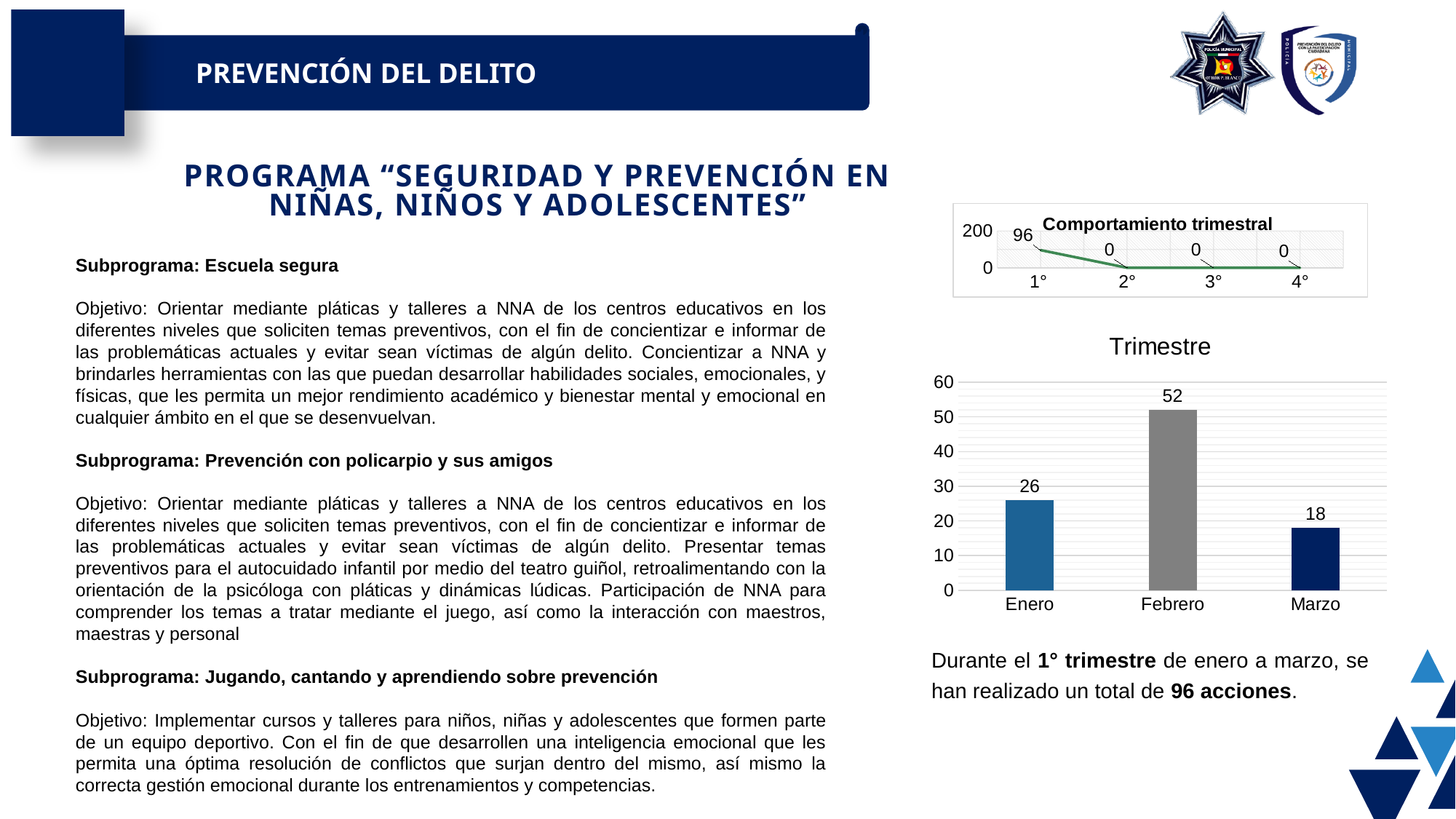
In the "Comportamiento trimestral" chart, what is the value for 3°? 0 What kind of chart is the "Comportamiento trimestral" chart? Line chart In the "Trimestre" chart, how many months are shown? 3 In the "Trimestre" chart, what is the value for Enero? 26 In the "Trimestre" chart, what is the value for Marzo? 18 In the "Trimestre" chart, which is larger, the value for Enero or the value for Marzo? Enero In the "Trimestre" chart, which month has the lowest value? Marzo What kind of chart is the "Trimestre" chart? Bar chart In the "Comportamiento trimestral" chart, what is the value for 1°? 96 In the "Trimestre" chart, what is the value for Febrero? 52 In the "Trimestre" chart, which month has the highest value? Febrero In the "Trimestre" chart, what is the difference between the values for Febrero and Enero? 26